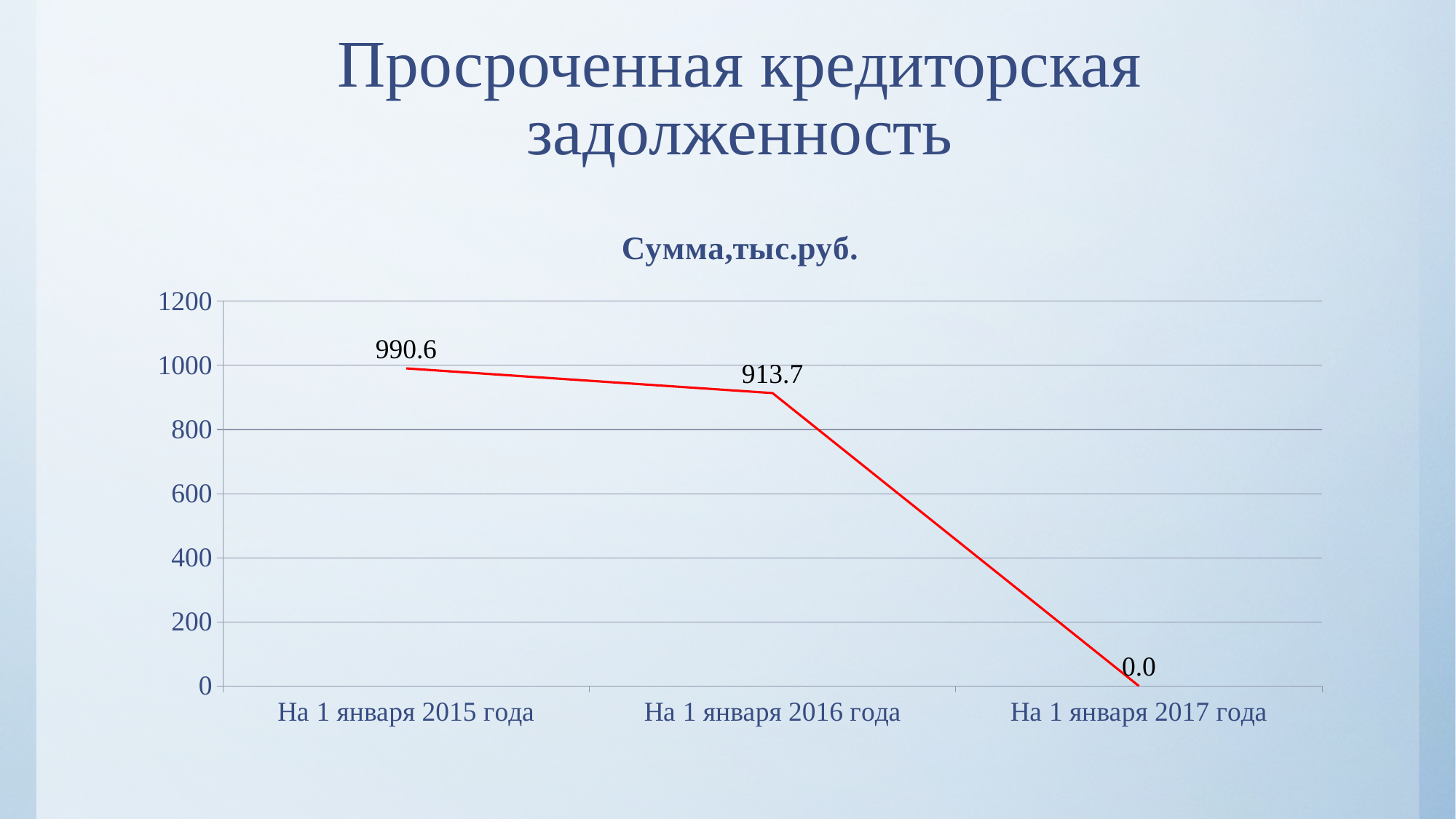
Do the values rise or fall from left to right along the x axis? fall What is the value for На 1 января 2016 года? 913.7 What is the value for На 1 января 2015 года? 990.6 What is the title of the chart? Сумма,тыс.руб. What kind of chart is shown on the slide? line chart How many data points are plotted on the chart? 3 What is the value for На 1 января 2017 года? 0.0 Which date has the highest value? На 1 января 2015 года Which is larger, the value for На 1 января 2016 года or На 1 января 2017 года? На 1 января 2016 года Which date has the lowest value? На 1 января 2017 года Is the value for На 1 января 2016 года greater or less than 1000? less What is the difference between the values for На 1 января 2015 года and На 1 января 2016 года? 76.9